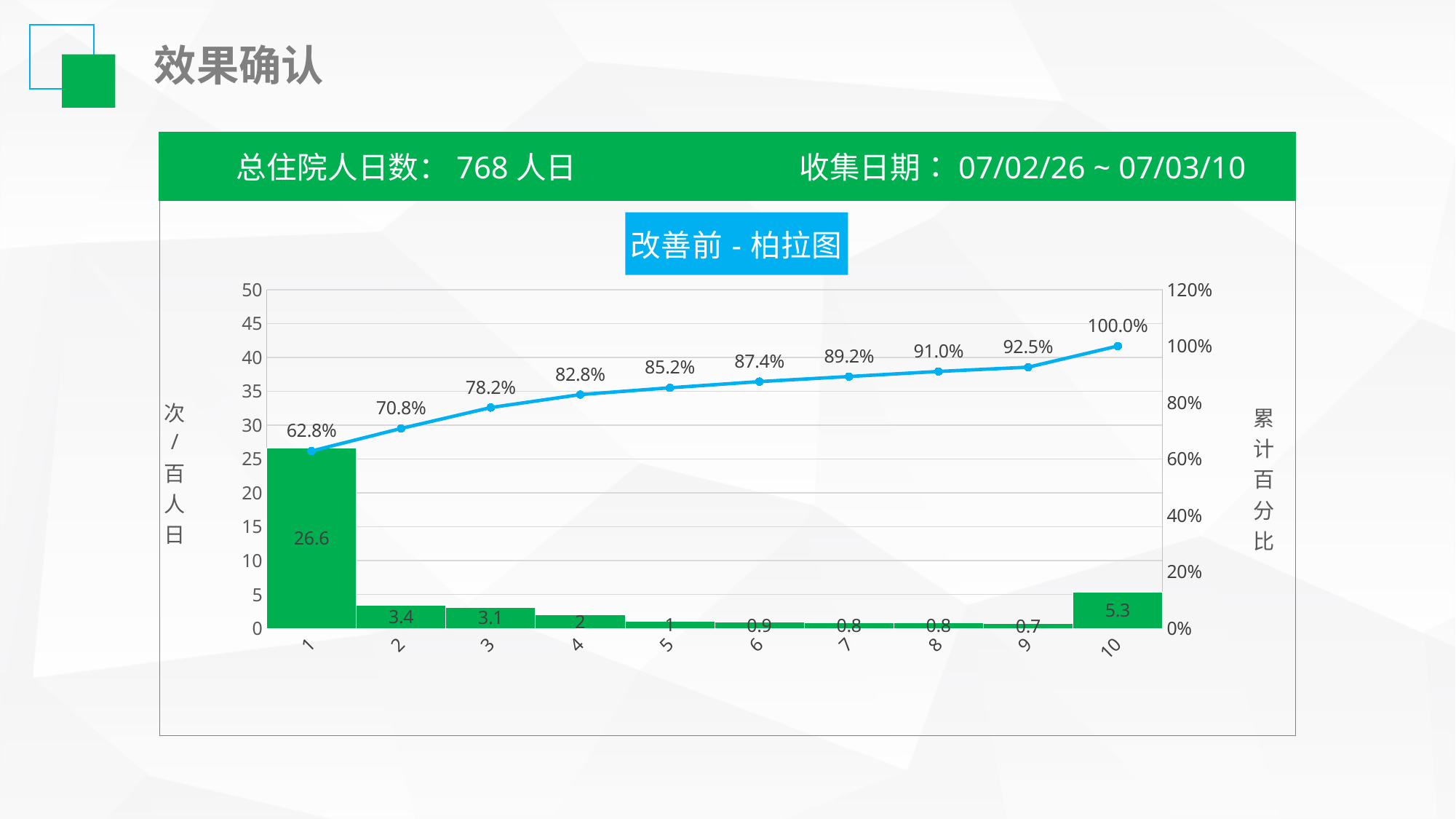
What is the title of the chart? 改善前 - 柏拉图 What is the difference between the bar values for category 1 and category 2? 23.2 Which category has the lowest bar value? 9 Does the cumulative percentage line rise or fall from category 1 to category 10? rise What is the bar value for category 1? 26.6 How many categories are shown on the x axis? 10 What is the cumulative percentage at category 4? 82.8% Which category has the highest bar value? 1 What is the difference between the cumulative percentages at category 2 and category 1? 8.0% What is the cumulative percentage at category 10? 100.0% What is the bar value for category 10? 5.3 Which has a larger bar value, category 2 or category 10? 10